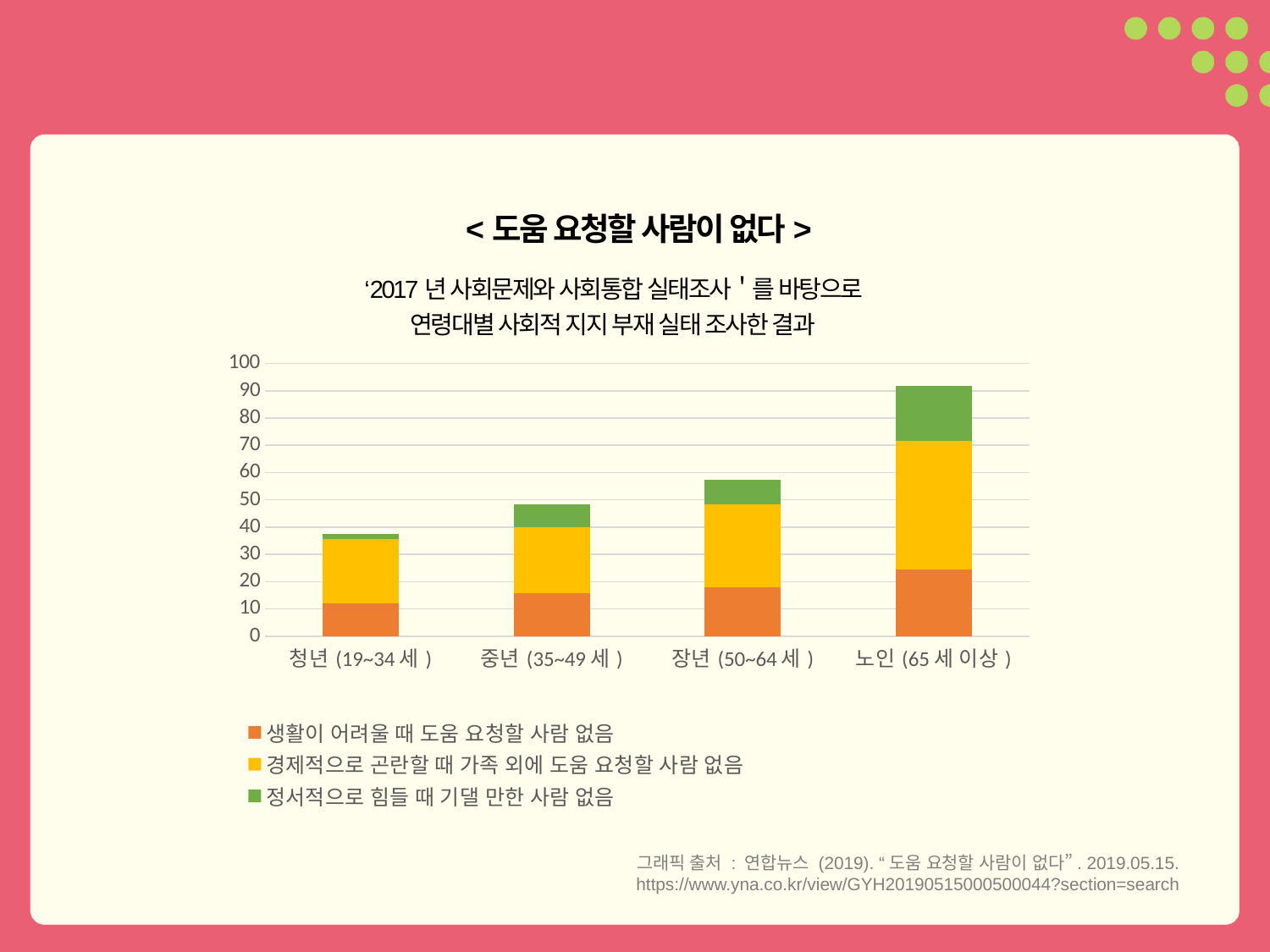
Do the stacked bar totals rise or fall from 청년 to 노인 along the x axis? Rise What colour represents '정서적으로 힘들 때 기댈 만한 사람 없음' in the legend? Green Is the total stacked value for 노인 (65세 이상) greater or less than 80? greater How many age-group categories are shown on the x axis? 4 Is the total stacked value for 청년 (19~34세) greater or less than 50? less What is the title of the chart? < 도움 요청할 사람이 없다 > What kind of chart is shown on the slide? Stacked bar chart How many series does the legend list? 3 Is the total stacked value for 장년 (50~64세) greater or less than 50? greater Which age group has the tallest stacked bar? 노인 (65세 이상) Which age group has the shortest stacked bar? 청년 (19~34세) Which has the larger '생활이 어려울 때 도움 요청할 사람 없음' segment, 노인 (65세 이상) or 청년 (19~34세)? 노인 (65세 이상)